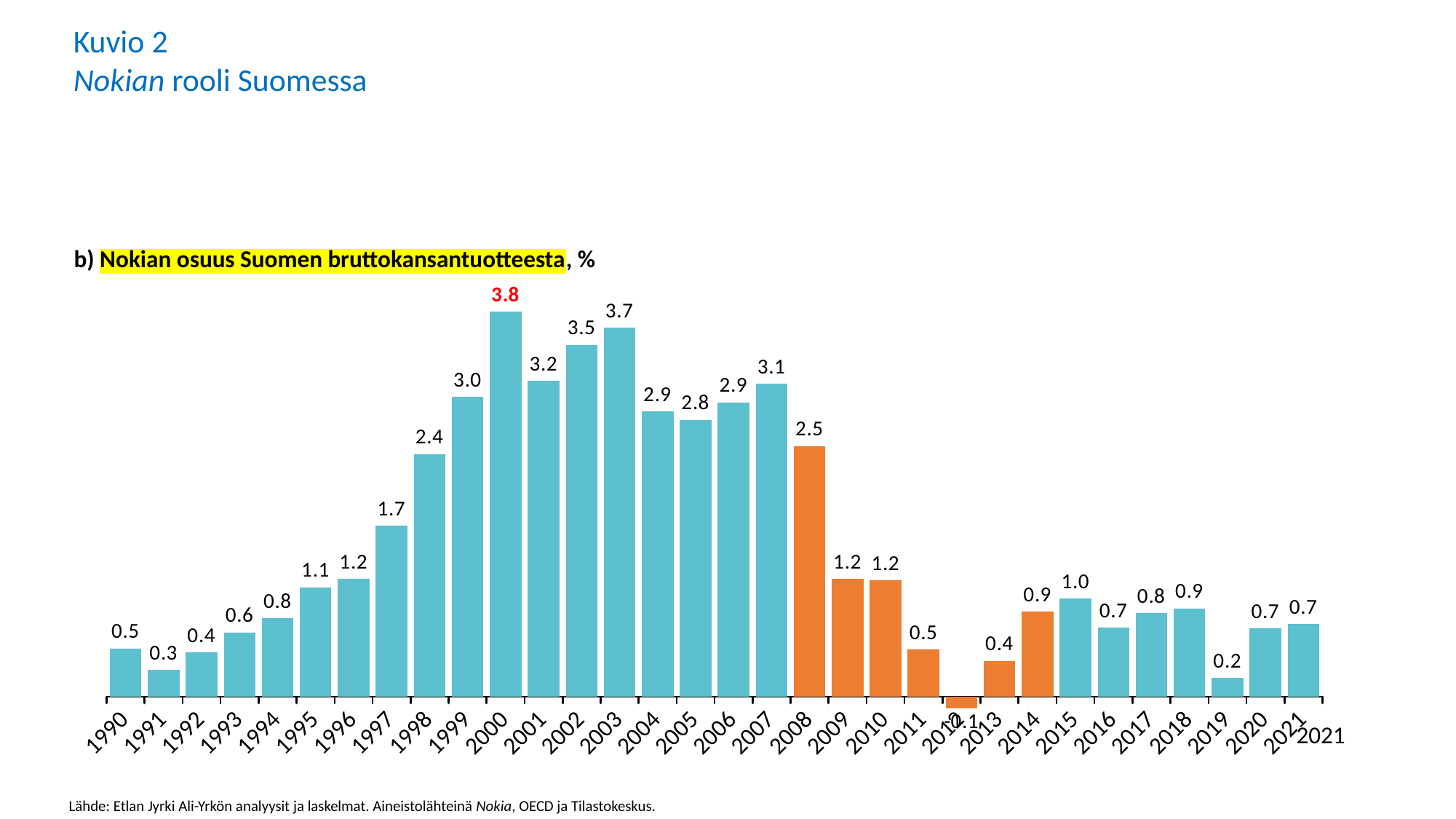
Which year has the highest value in the chart? 2000 What is the difference between the values for 2000 and 2021? 3.1 Which year has the lowest value in the chart? 2012 What kind of chart is shown on the slide? Bar chart Which year has the larger value, 2002 or 2007? 2002 Which years are shown with orange bars instead of blue? 2008–2014 How many years (bars) are plotted in the chart? 32 What value is shown for 2008? 2.5 Do the values rise or fall from 1990 to 2000? Rise What is the difference between the values for 2003 and 2004? 0.8 What was Nokia's share of Finland's GDP in 2000? 3.8 What value is shown for 1997? 1.7